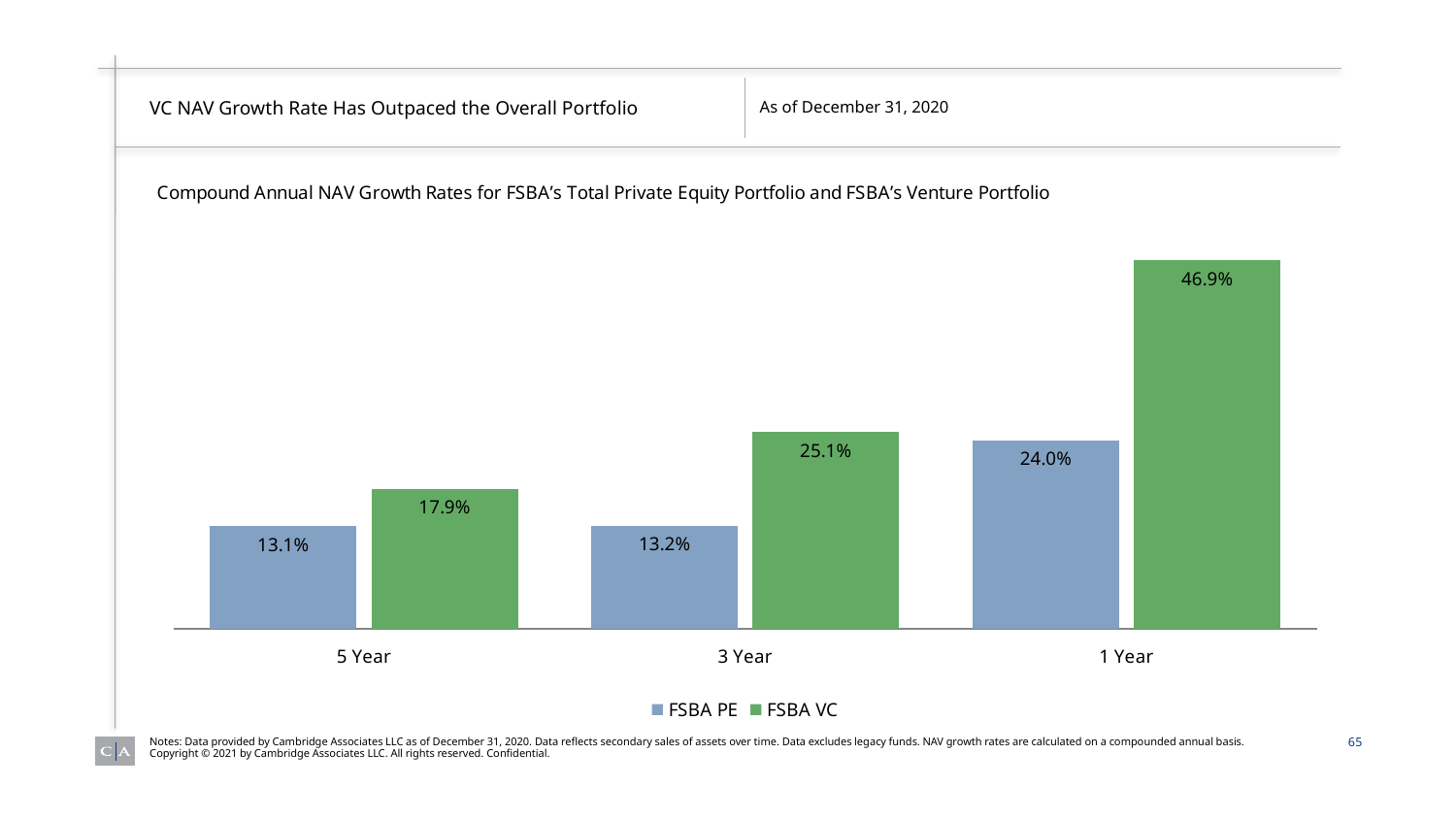
What is the FSBA VC value for 1 Year? 46.9% How many series does the legend list? 2 What is the FSBA PE value for 1 Year? 24.0% What is the difference between the FSBA VC and FSBA PE values for 1 Year? 22.9% What is the difference between the FSBA VC and FSBA PE values for 5 Year? 4.8% Which period has the lowest FSBA PE value? 5 Year What is the FSBA PE value for 5 Year? 13.1% What is the FSBA VC value for 3 Year? 25.1% What kind of chart is shown on the slide? Bar chart How many periods are shown on the x axis? 3 Which period has the highest FSBA VC value? 1 Year Which is larger for 3 Year, FSBA PE or FSBA VC? FSBA VC